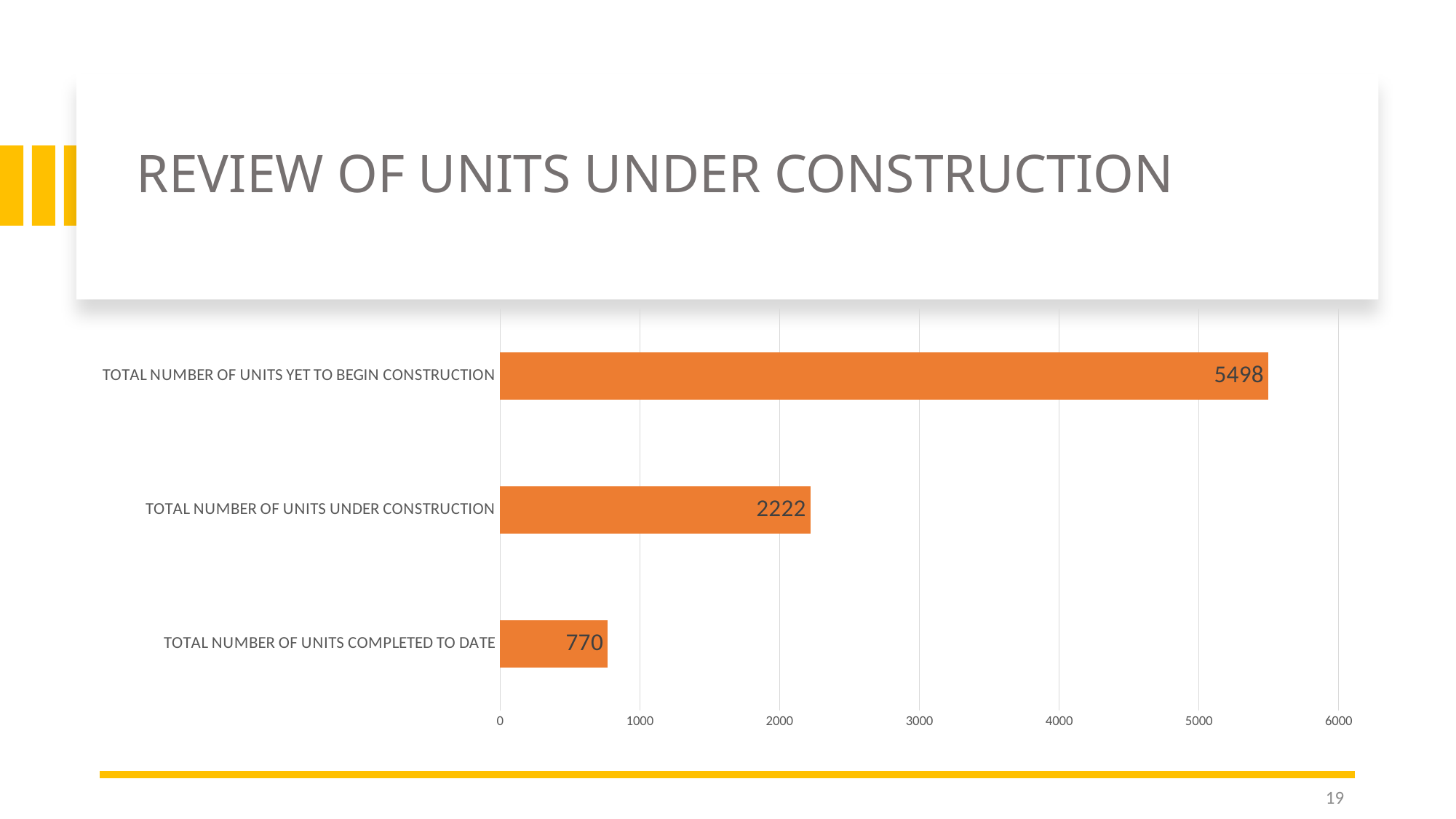
What kind of chart is shown on the slide? Bar chart What is the difference between the number of units under construction and the number of units completed to date? 1452 What is the total number of units yet to begin construction? 5498 Is the value for total number of units under construction greater or less than 2000? greater How many categories are shown in the chart? 3 Which is larger: the number of units under construction or the number of units completed to date? Total number of units under construction What is the total number of units under construction? 2222 Which category has the highest value? Total number of units yet to begin construction What is the title of the slide? Review of Units Under Construction Which category has the lowest value? Total number of units completed to date What is the difference between the number of units yet to begin construction and the number of units under construction? 3276 What is the total number of units completed to date? 770